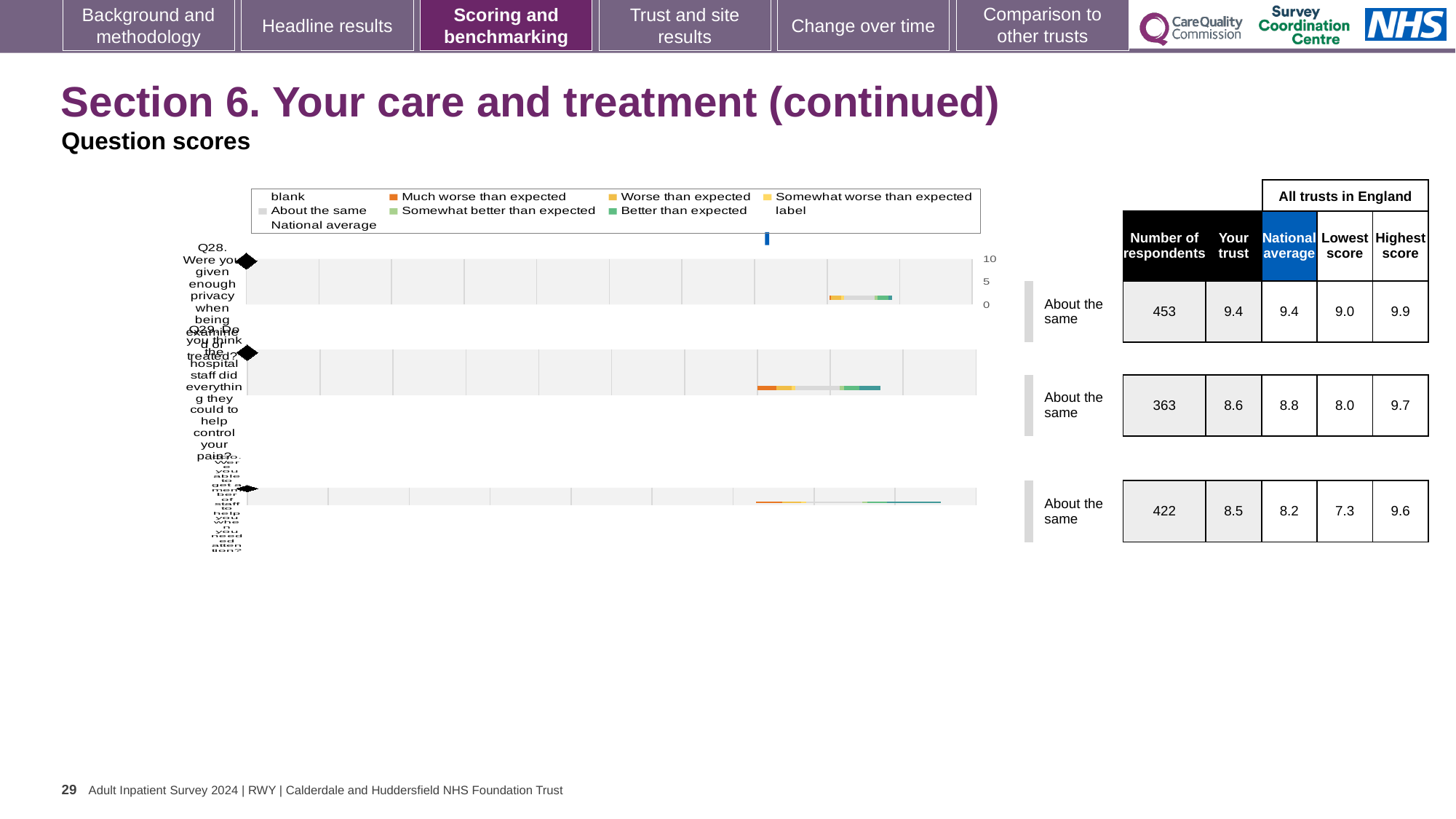
What benchmark category is shown for all three questions on this slide? About the same Which question has the lowest 'Lowest score' across all trusts in England? Q30 (the bottom row) How many respondents answered Q28? 453 For Q29, which is larger: the 'Your trust' score or the national average? National average For Q29, what is the difference between the highest score and the lowest score across all trusts in England? 1.7 What is the highest score across all trusts in England for Q28? 9.9 Which question has the highest 'Your trust' score? Q28 How many questions (rows) are plotted in the chart? 3 How many entries does the chart legend list? 9 What is the national average score for Q29 (Do you think the hospital staff did everything they could to help control your pain?)? 8.8 What kind of chart is used to show the question scores on this slide? bar chart What is the 'Your trust' score for Q28 (Were you given enough privacy when being examined or treated?)? 9.4